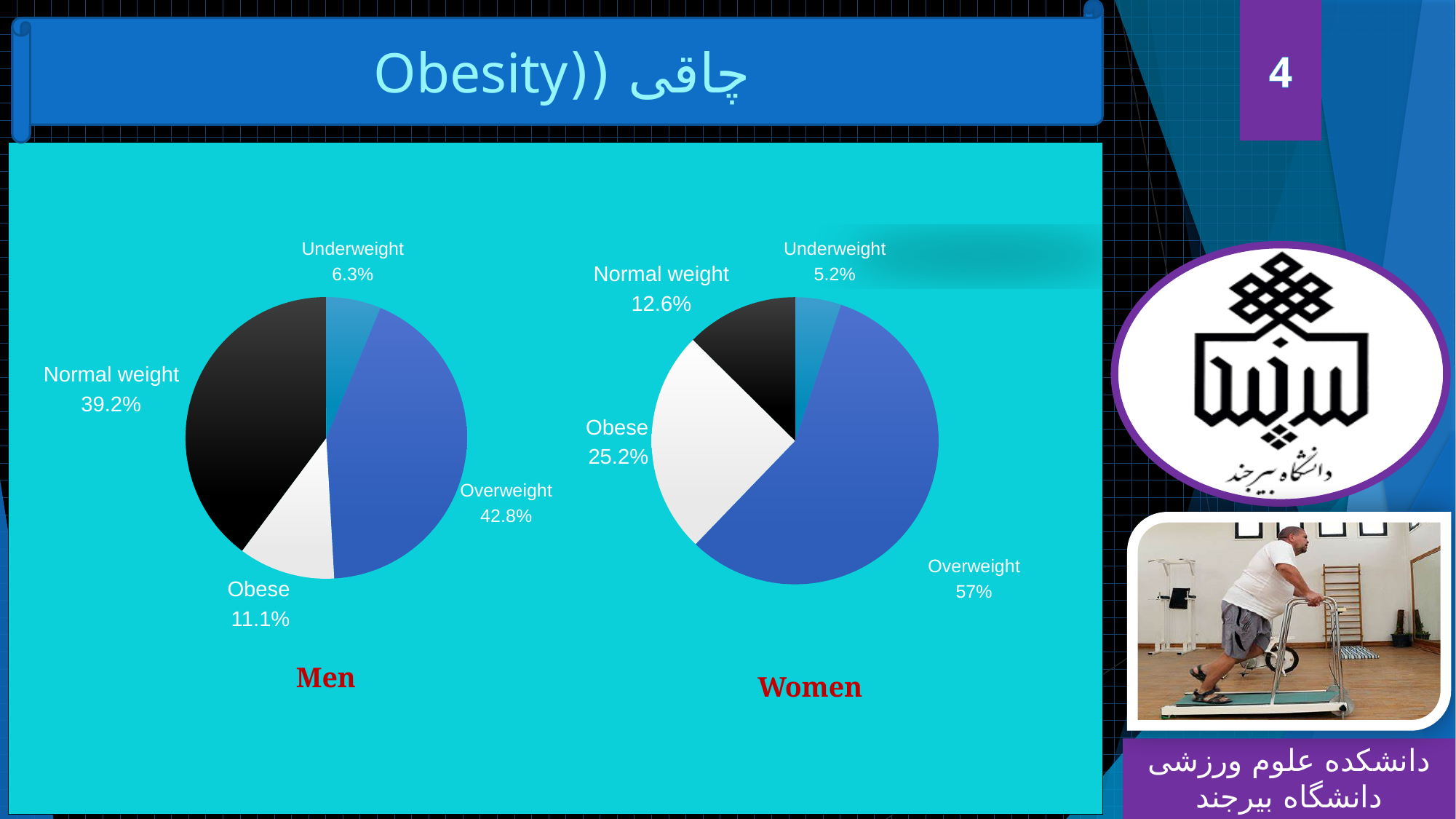
In the Women pie chart, which category has the largest share? Overweight In the Men pie chart, what percentage is labelled Overweight? 42.8% What colour is the Overweight slice in the Men pie chart? Blue In the Men pie chart, what percentage is labelled Normal weight? 39.2% What type of chart is used for the Women data? Pie chart In the Women pie chart, what percentage is labelled Underweight? 5.2% In the Men pie chart, what is the difference between the Overweight and Normal weight percentages? 3.6% In the Men pie chart, which category has the smallest share? Underweight In the Women pie chart, what percentage is labelled Obese? 25.2% In the Women pie chart, what is the difference between the Overweight and Obese percentages? 31.8% Which is larger: the Obese share in the Men chart or the Obese share in the Women chart? Women How many categories does the Men pie chart show? 4